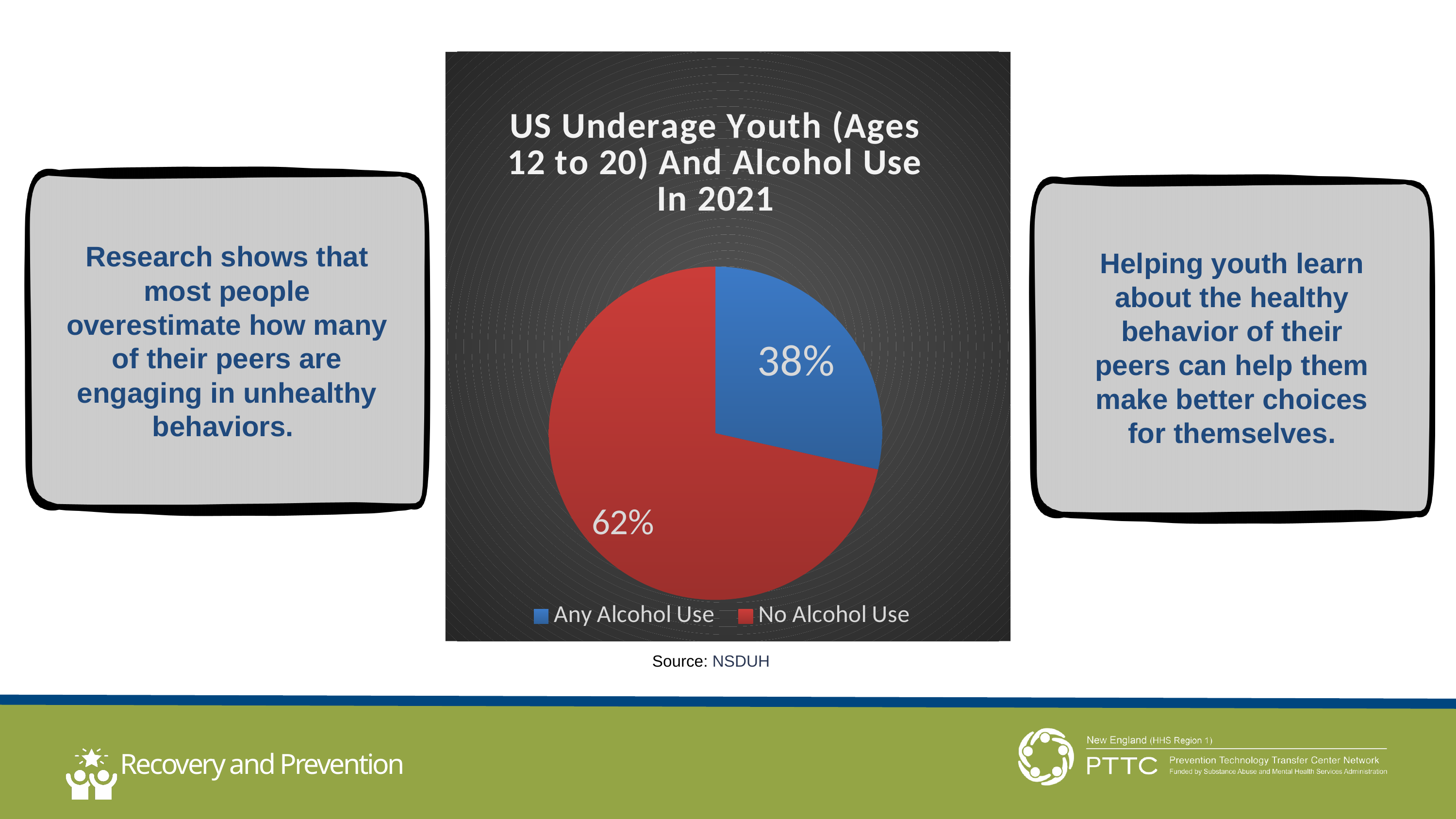
How many entries does the legend list? 2 What is the difference in percentage points between No Alcohol Use and Any Alcohol Use? 24 What percentage of the pie is labelled for Any Alcohol Use? 38% What kind of chart is shown on the slide? Pie chart Which is larger, the share for Any Alcohol Use or the share for No Alcohol Use? No Alcohol Use What colour is the slice for Any Alcohol Use? Blue How many categories does the pie chart show? 2 What share of the pie does the No Alcohol Use slice represent? 62% What percentage of the pie is labelled for No Alcohol Use? 62% What is the title of the chart? US Underage Youth (Ages 12 to 20) And Alcohol Use In 2021 Which category has the largest share of the pie? No Alcohol Use Which category has the smallest share of the pie? Any Alcohol Use